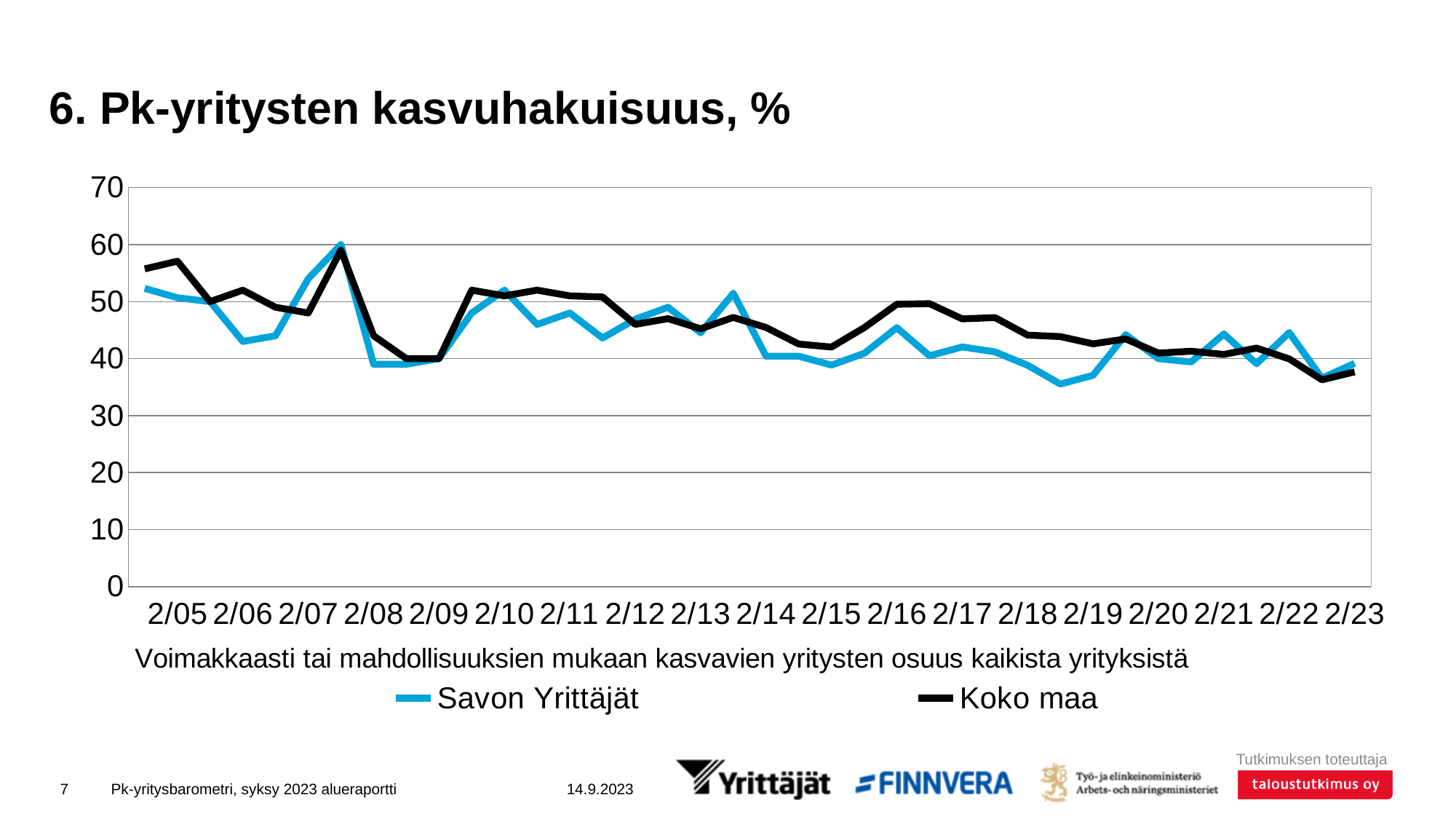
At 2/05, which series has the higher value, Savon Yrittäjät or Koko maa? Koko maa Is the value for Koko maa at 2/06 greater or less than 50? greater How many year labels are shown on the x axis? 19 Is the value for Savon Yrittäjät at 2/06 greater or less than 50? less Which colour is used for the Savon Yrittäjät line? blue What kind of chart is shown on the slide? line chart Is the value for Koko maa at 2/23 greater or less than 40? less Overall, do the values for Koko maa rise or fall from 2/05 to 2/23? fall How many series does the legend list? 2 At 2/19, which series has the higher value, Savon Yrittäjät or Koko maa? Koko maa